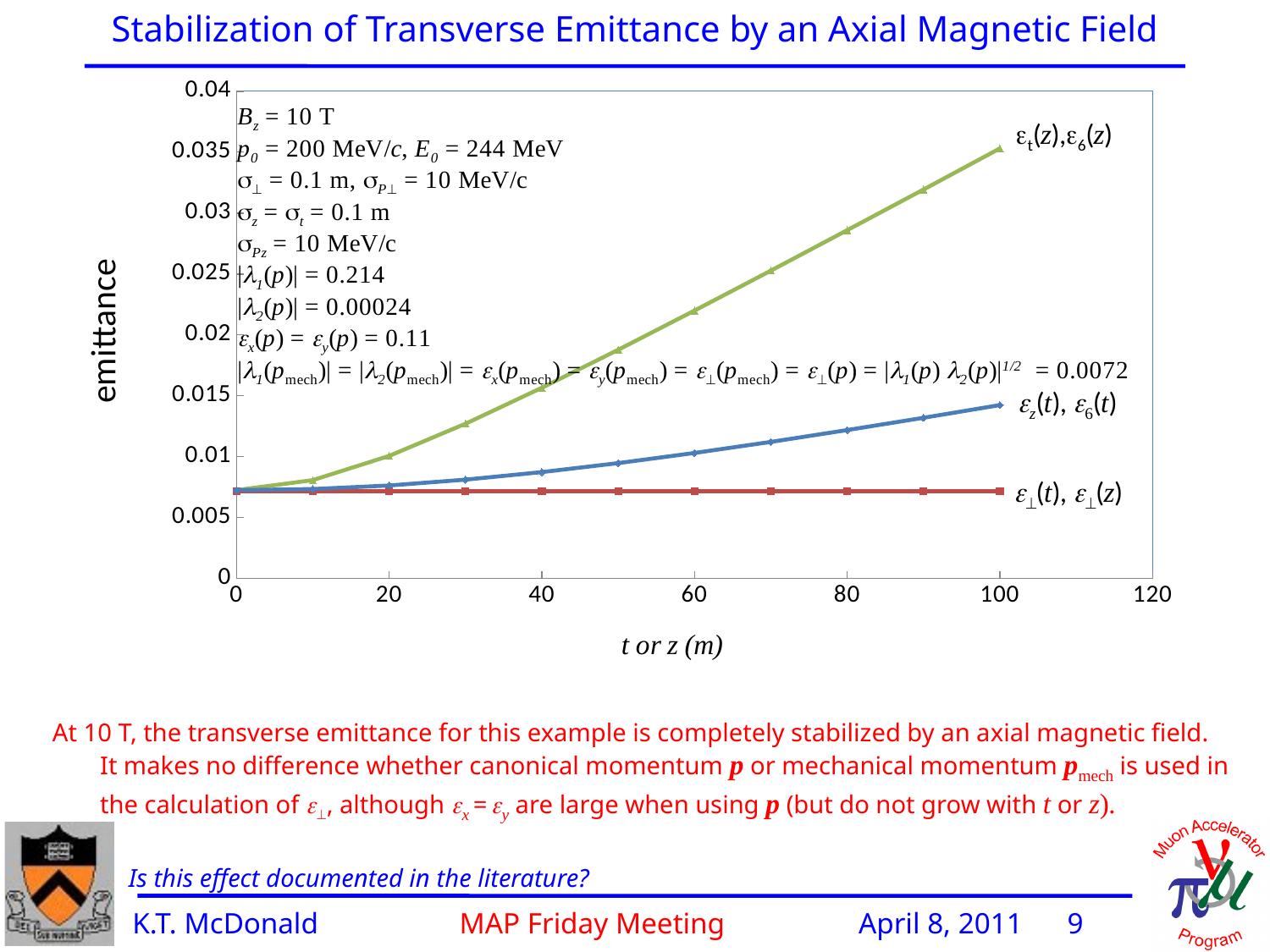
What is the label of the x axis? t or z (m) Is the value of the ε_z(t), ε_6(t) curve at t = 100 m greater or less than 0.015? less What is the label of the y axis? emittance Which curve has the lowest emittance value at t or z = 100 m? ε_⊥(t), ε_⊥(z) At t or z = 100 m, which is larger: the ε_z(t), ε_6(t) curve or the ε_⊥(t), ε_⊥(z) curve? ε_z(t), ε_6(t) Which curve reaches the highest emittance value at t or z = 100 m? ε_t(z), ε_6(z) Does the ε_t(z), ε_6(z) curve rise or fall as z increases? rises What kind of chart is shown on the slide? line chart Is the value of the ε_⊥(t), ε_⊥(z) curve greater or less than 0.01? less Is the value of the ε_t(z), ε_6(z) curve at z = 80 m greater or less than 0.025? greater How many curves (series) are plotted on the chart? 3 Does the ε_⊥(t), ε_⊥(z) curve rise, fall, or stay flat as t or z increases? stays flat